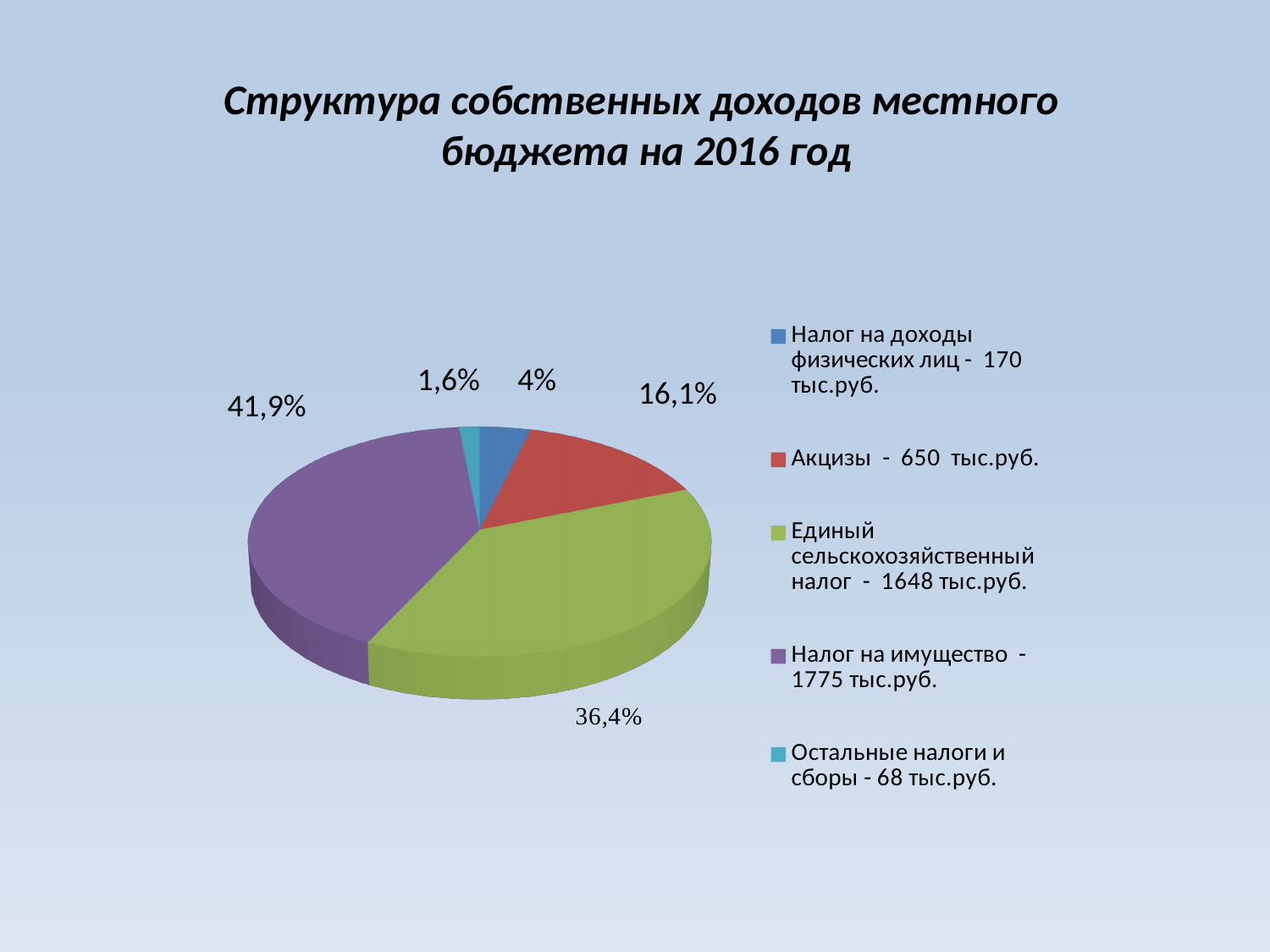
What share of the pie does Налог на доходы физических лиц have? 4% What share of the pie does Остальные налоги и сборы have? 1,6% What share of the pie does Акцизы have? 16,1% Which is larger: the share for Акцизы or the share for Налог на доходы физических лиц? Акцизы How many slices does the pie chart have? 5 Which category has the smallest share of the pie? Остальные налоги и сборы What is the difference in percentage points between the shares of Налог на имущество and Единый сельскохозяйственный налог? 5,5 What kind of chart is shown on the slide? Pie chart What amount in тыс.руб. does the legend give for Акцизы? 650 тыс.руб. Which category has the largest share of the pie? Налог на имущество